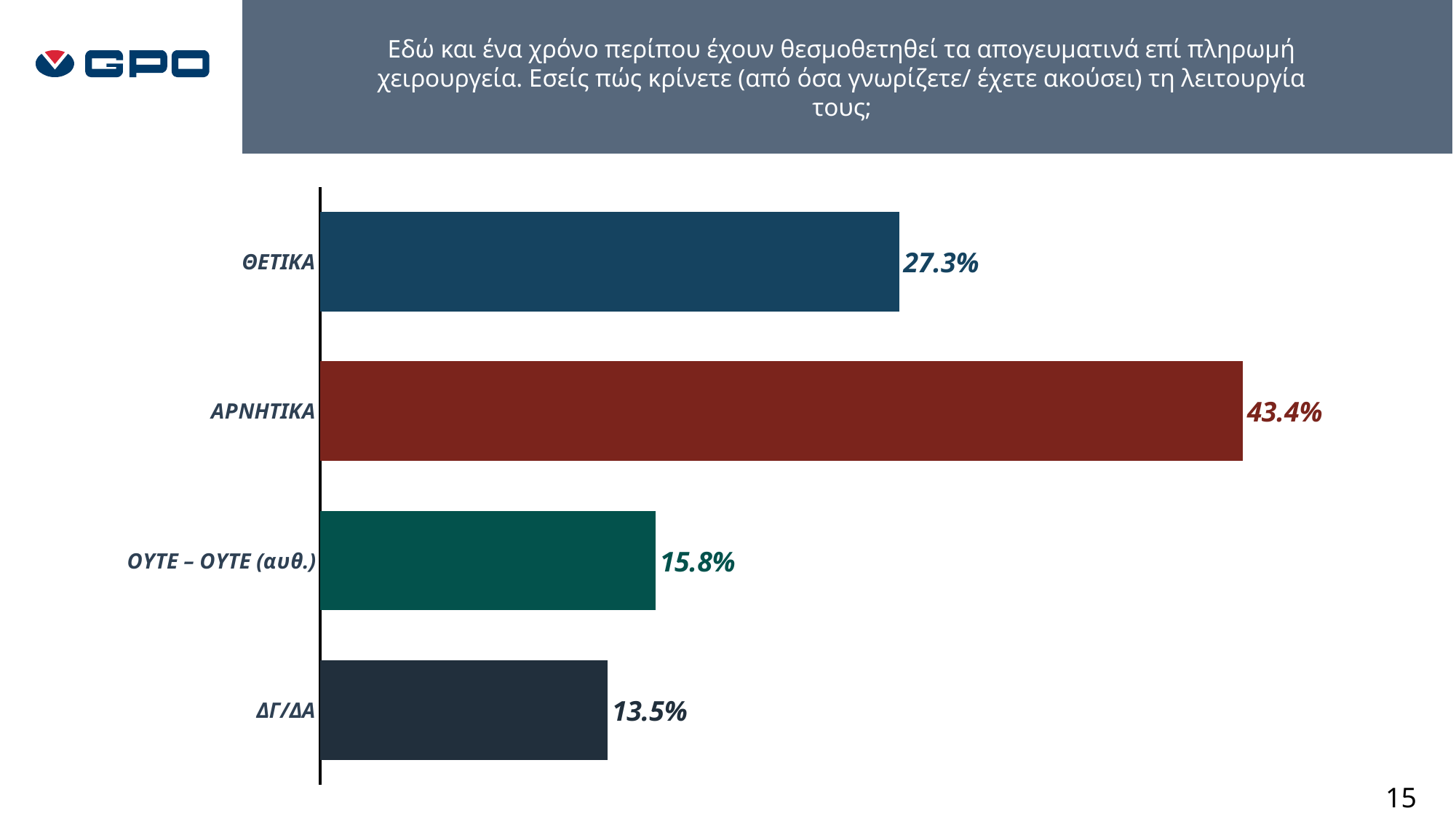
What is the difference between the values for ΑΡΝΗΤΙΚΑ and ΘΕΤΙΚΑ? 16.1% What is the value for ΘΕΤΙΚΑ? 27.3% Which category has the highest value? ΑΡΝΗΤΙΚΑ What is the value for ΔΓ/ΔΑ? 13.5% How many categories are shown in the chart? 4 What is the value for ΟΥΤΕ – ΟΥΤΕ (αυθ.)? 15.8% What is the value for ΑΡΝΗΤΙΚΑ? 43.4% What kind of chart is shown on the slide? Bar chart Which category has the lowest value? ΔΓ/ΔΑ Which is larger, the value for ΘΕΤΙΚΑ or the value for ΑΡΝΗΤΙΚΑ? ΑΡΝΗΤΙΚΑ What is the difference between the values for ΟΥΤΕ – ΟΥΤΕ (αυθ.) and ΔΓ/ΔΑ? 2.3% What colour is the bar for ΑΡΝΗΤΙΚΑ? Dark red